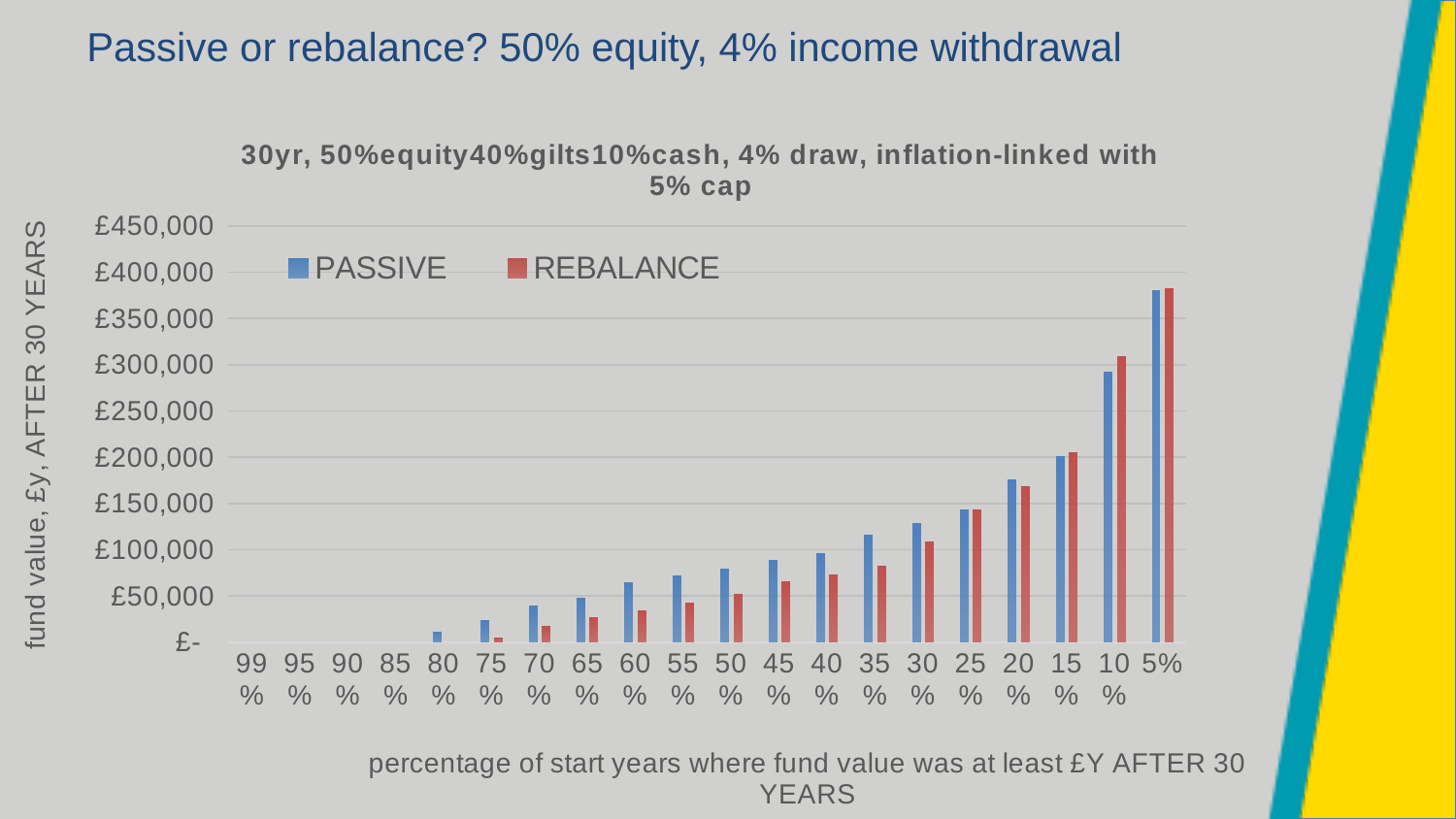
At 35%, which series has the larger value, PASSIVE or REBALANCE? PASSIVE Which category has the highest PASSIVE value? 5% Do the fund values rise or fall moving from 99% on the left to 5% on the right of the x axis? rise At 10%, which series has the larger value, PASSIVE or REBALANCE? REBALANCE Is the PASSIVE value for 10% greater or less than £250,000? greater How many series does the chart legend list? 2 What kind of chart is shown on the slide? bar chart Is the PASSIVE value for 30% greater or less than £150,000? less Is the PASSIVE value for 50% greater or less than £50,000? greater How many percentage categories are shown along the x axis? 20